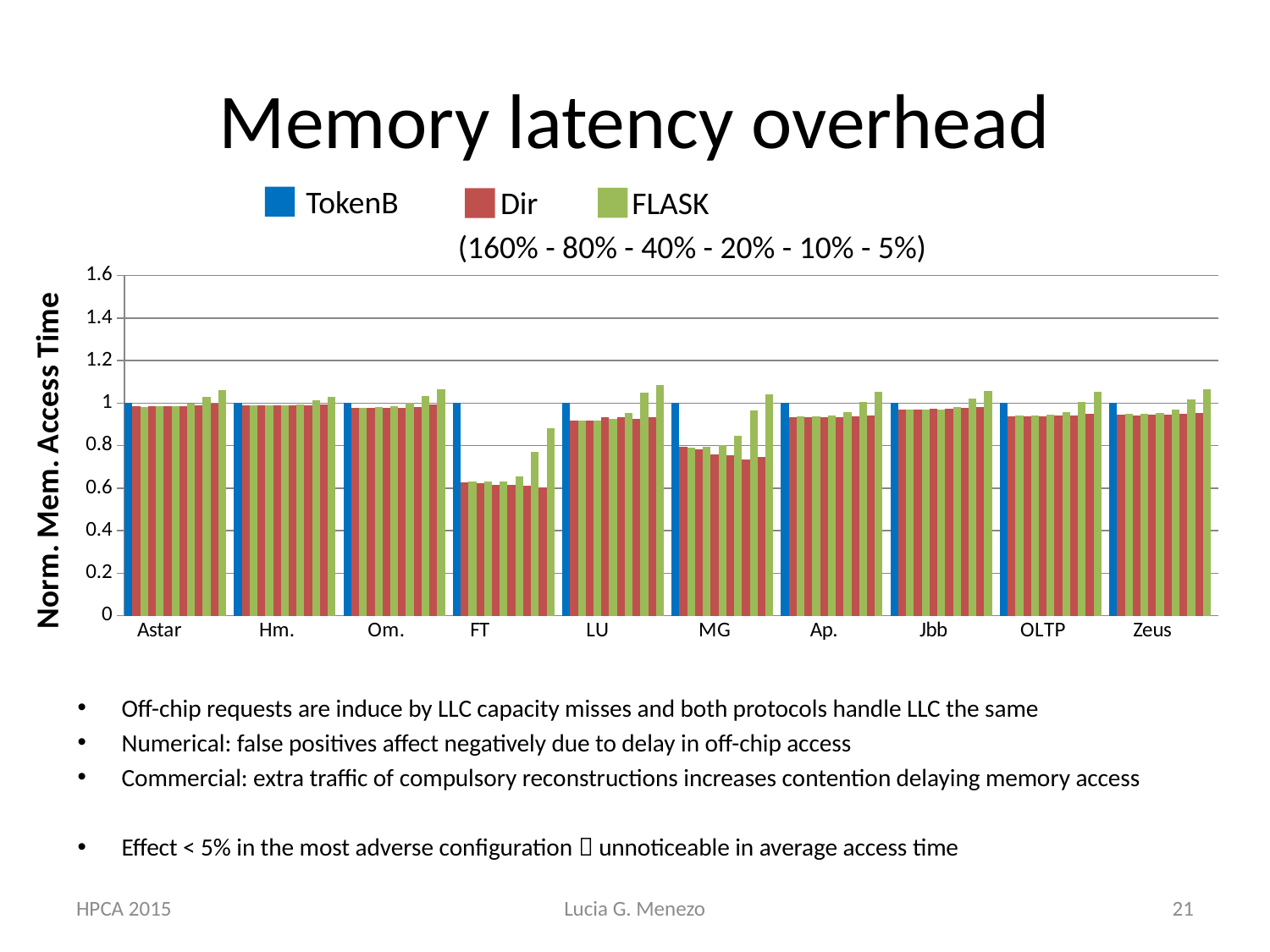
Are the Dir bars for Astar greater or less than 0.8? greater Are the Dir bars for FT greater or less than 0.4? greater Are the Dir bars for FT greater or less than 0.8? less Which benchmark has the lowest normalized memory access time values in the chart? FT Which benchmark has larger Dir values, FT or MG? MG How many series does the chart's legend list? 3 What is the title of the chart's y axis? Norm. Mem. Access Time How many benchmark categories are shown along the x axis of the chart? 10 Which benchmark has larger Dir values, Jbb or FT? Jbb What kind of chart is shown on the slide? bar chart Which series is shown in green in the chart's legend? FLASK